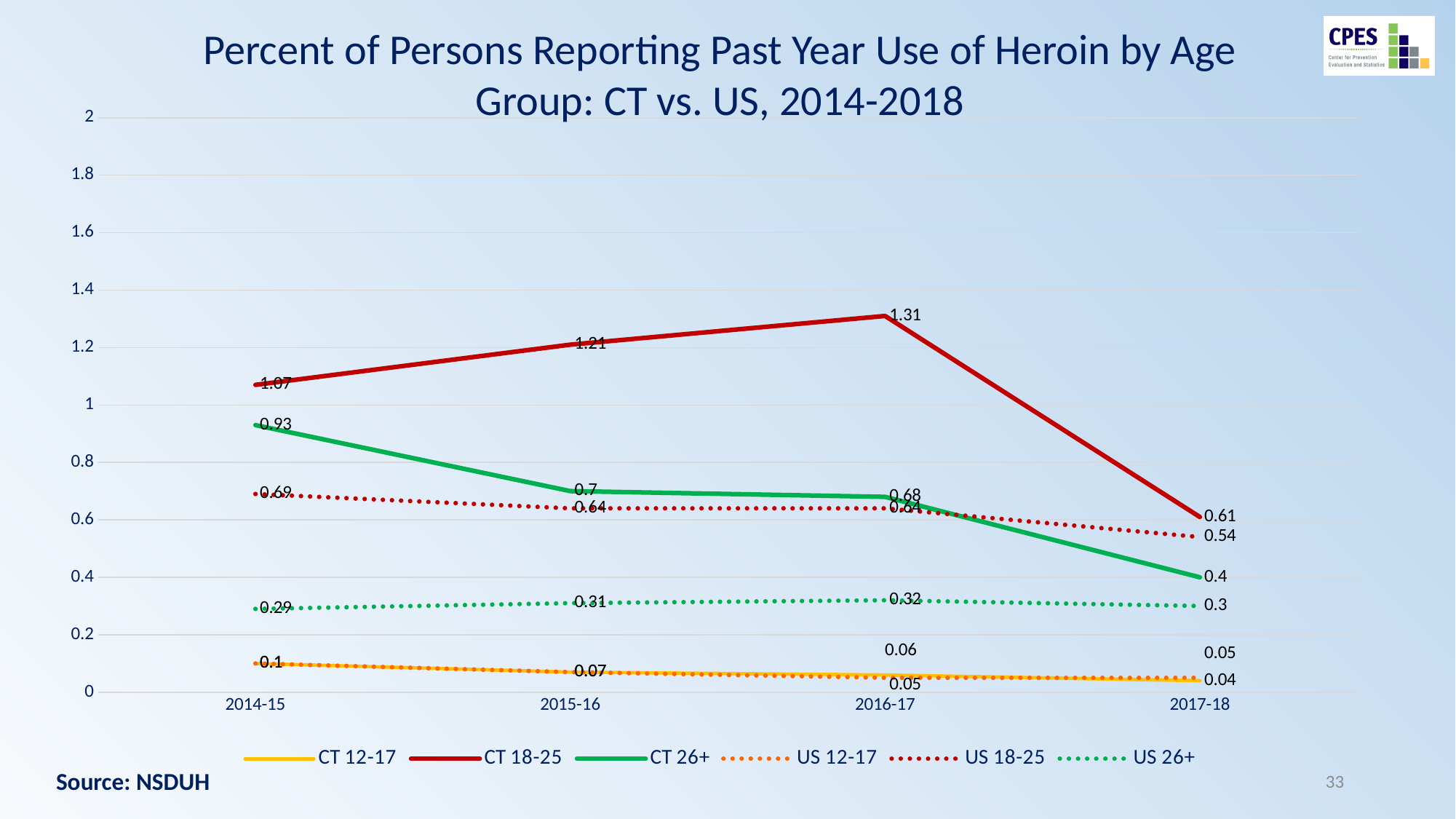
What is the difference between CT 18-25 and US 18-25 in 2014-15? 0.38 How many series does the legend list? 6 What is the value for US 18-25 in 2017-18? 0.54 In which period is the CT 26+ value lowest? 2017-18 In which period is the CT 18-25 value highest? 2016-17 How many time periods are shown on the x axis? 4 By how much did the CT 18-25 value fall from 2016-17 to 2017-18? 0.7 Which is larger in 2015-16, CT 26+ or US 18-25? CT 26+ What is the value for US 26+ in 2016-17? 0.32 What is the value for CT 26+ in 2014-15? 0.93 What kind of chart is shown on the slide? Line chart What is the value for CT 18-25 in 2016-17? 1.31